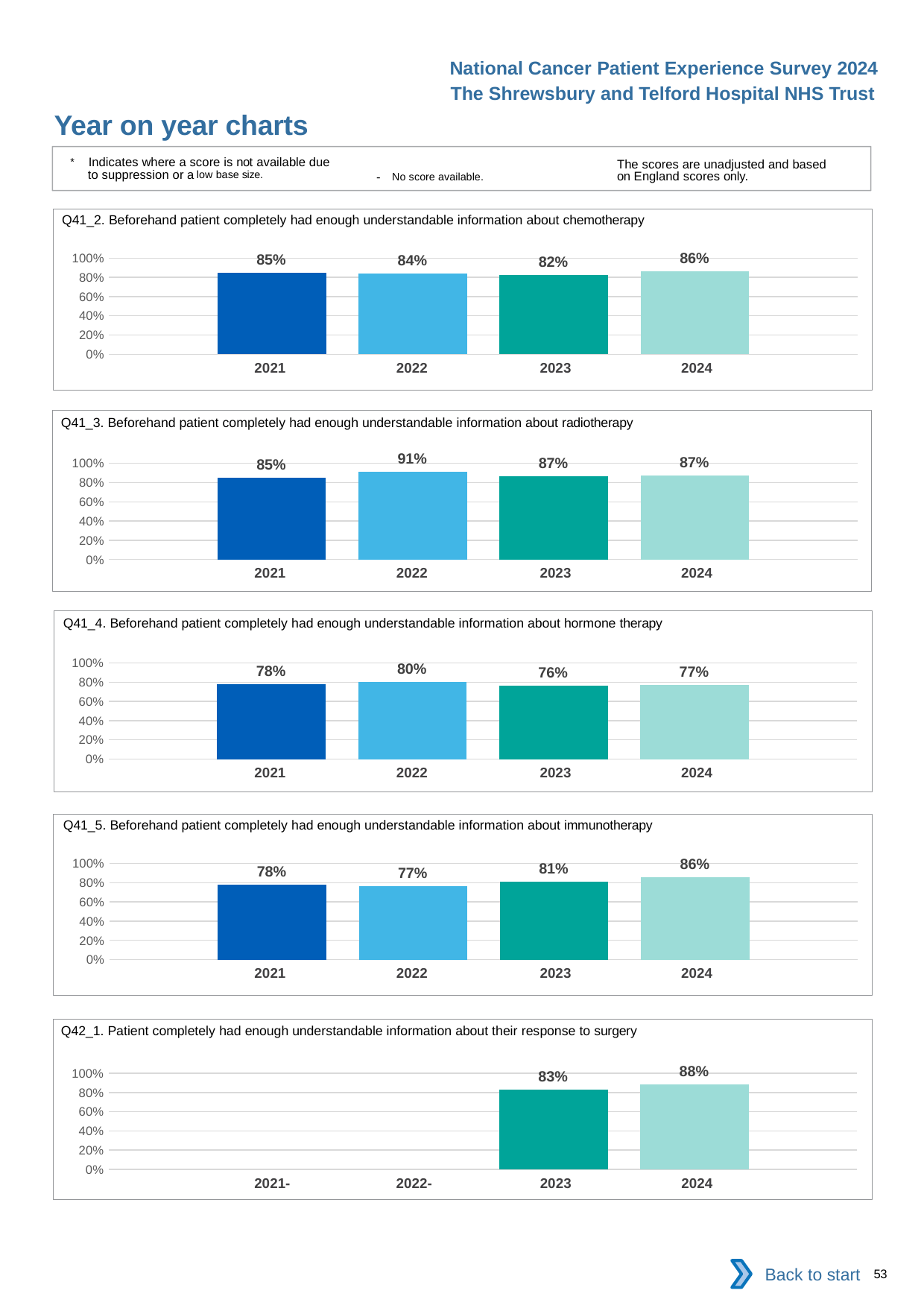
In the Q41_2 chart (chemotherapy), is the value for 2023 greater or less than 60%? greater In the Q41_4 chart (hormone therapy), which year has the lowest value? 2023 In the Q41_5 chart (immunotherapy), is the value for 2021 or 2023 larger? 2023 In the Q42_1 chart (response to surgery), what is the value for 2023? 83% What kind of chart is the Q41_2 chart (chemotherapy)? Bar chart In the Q41_2 chart (chemotherapy), what is the value for 2024? 86% In the Q42_1 chart (response to surgery), how many years have a plotted bar? 2 In the Q41_5 chart (immunotherapy), what is the difference between the 2024 and 2023 values? 5% How many charts are shown on the slide? 5 In the Q41_3 chart (radiotherapy), which year has the highest value? 2022 In the Q41_4 chart (hormone therapy), what is the value for 2022? 80% In the Q41_3 chart (radiotherapy), what is the difference between the 2022 and 2021 values? 6%